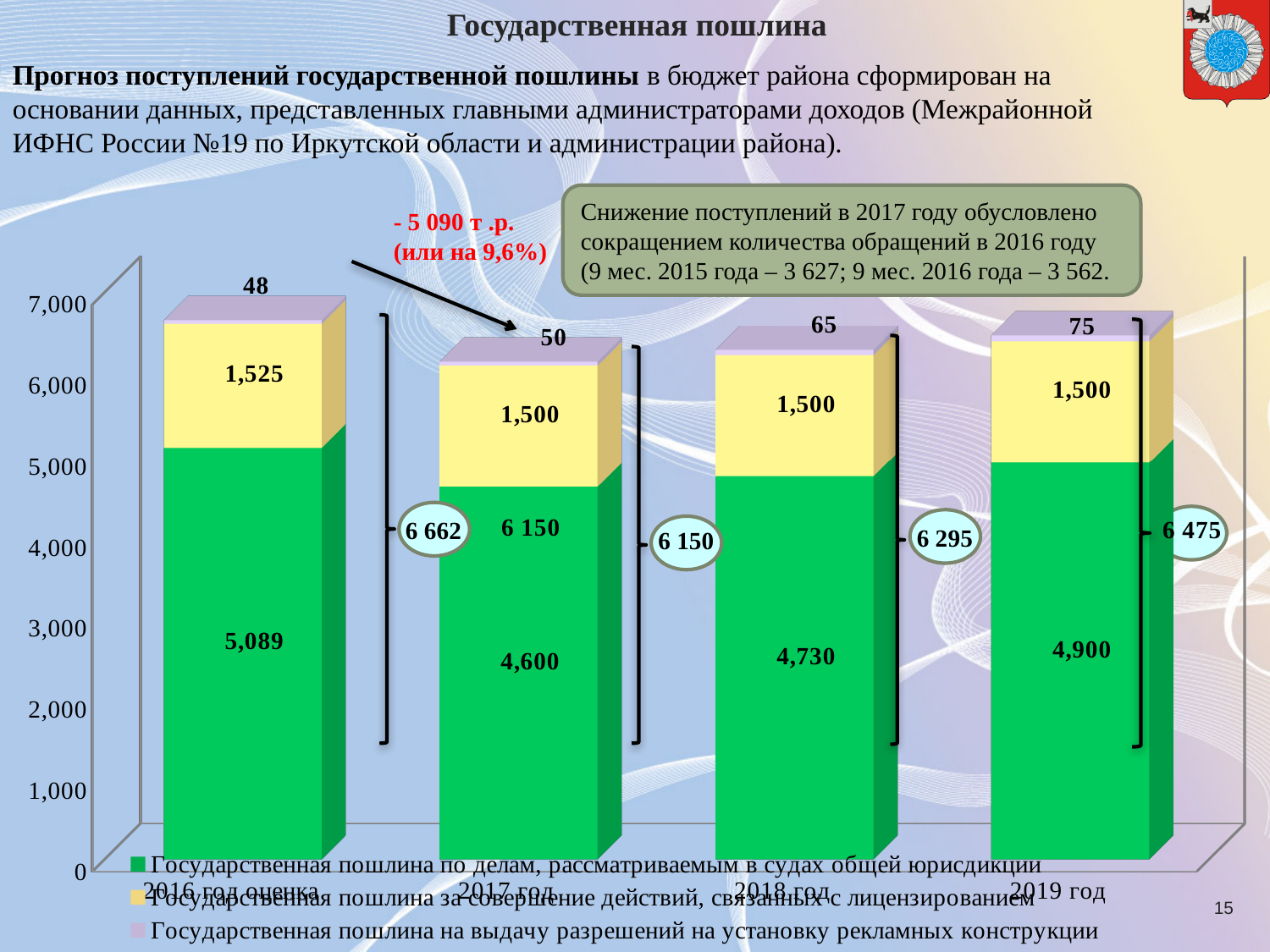
What is the difference between the green series values for 2019 год and 2018 год? 170 Which year has the lowest value for the green series (courts of general jurisdiction)? 2017 год What is the value of the purple series (Государственная пошлина на выдачу разрешений на установку рекламных конструкции) for 2019 год? 75 What is the value of the yellow series (Государственная пошлина за совершение действий, связанных с лицензированием) for 2016 год оценка? 1,525 What is the total of the stacked bar for 2018 год? 6 295 What is the value of the green series (Государственная пошлина по делам, рассматриваемым в судах общей юрисдикции) for 2016 год оценка? 5,089 How many series does the legend list? 3 Do the stacked bar totals rise or fall from 2017 год to 2019 год? rise Is the green series value for 2017 год larger or smaller than for 2016 год оценка? smaller What type of chart is shown on the slide? stacked bar chart How many year categories are shown on the x axis? 4 Which year has the highest stacked bar total? 2016 год оценка